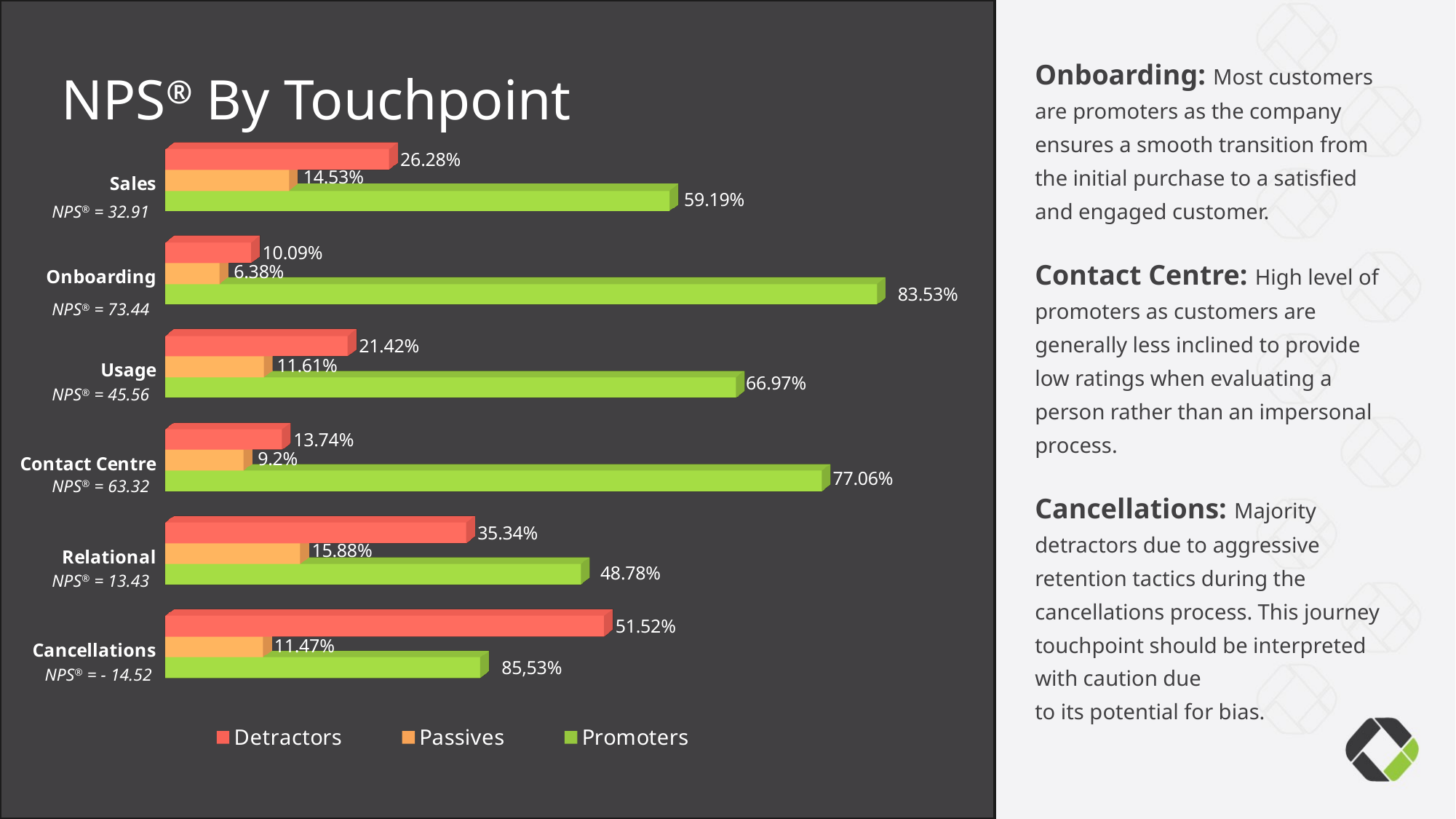
What is the title of the chart? NPS® By Touchpoint What is the Passives value for Contact Centre? 9.2% What is the Promoters value for Usage? 66.97% Which touchpoint has the lowest Passives value? Onboarding What is the Detractors value for Sales? 26.28% How many series does the legend list? 3 How many touchpoints are shown on the chart? 6 Which is larger, the Detractors value for Relational or the Detractors value for Usage? Relational What is the Promoters value for Onboarding? 83.53% What is the difference between the Promoters values for Contact Centre and Relational? 28.28% Which touchpoint has the highest Detractors value? Cancellations What kind of chart is shown on the slide? Bar chart